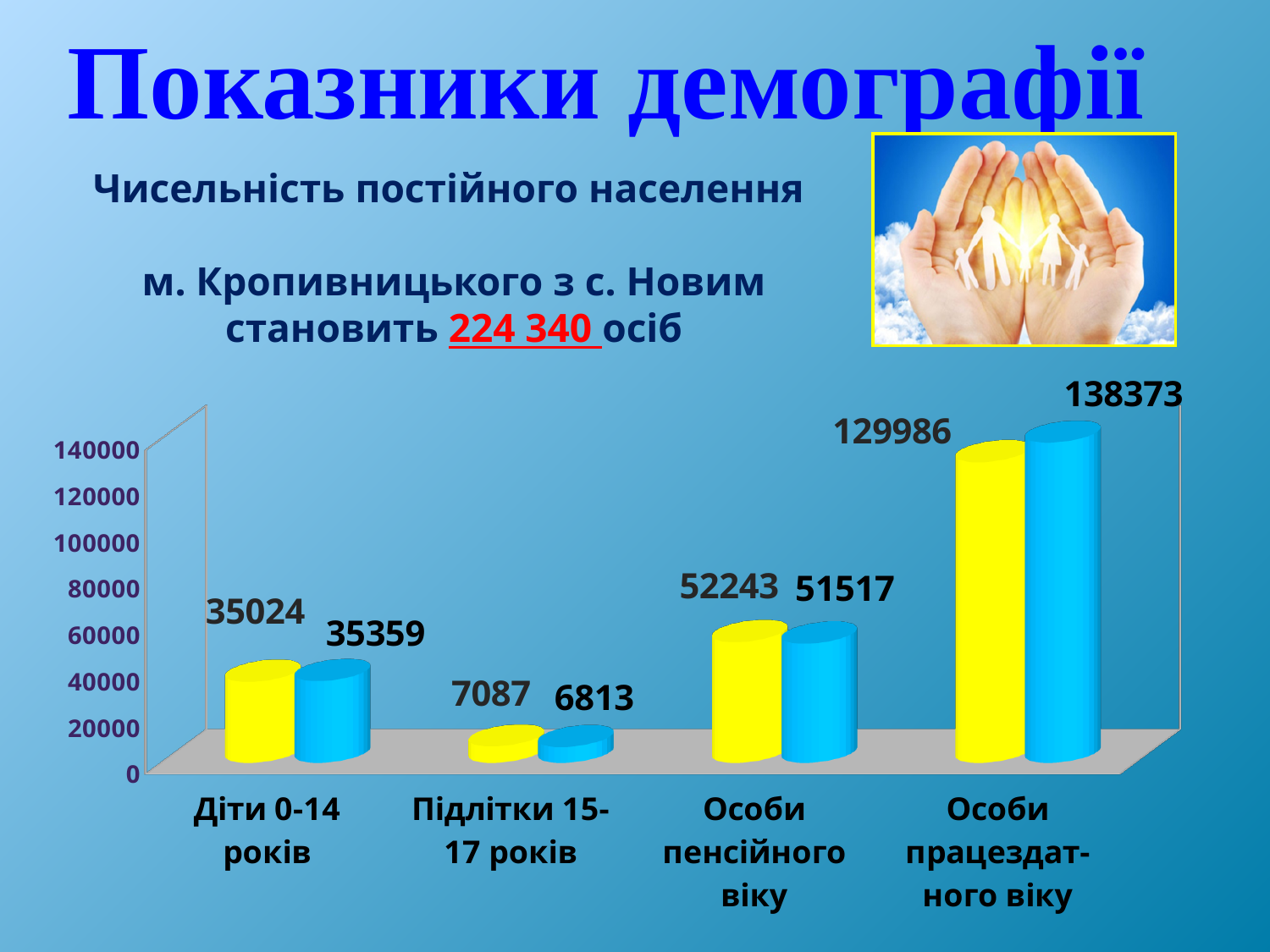
How many categories are shown on the x axis of the chart? 4 What is the value of the blue bar for Підлітки 15-17 років? 6813 What kind of chart is shown on the slide? bar chart Which is larger for Підлітки 15-17 років: the yellow bar or the blue bar? the yellow bar What total population figure is stated in the text above the chart? 224 340 What is the value of the yellow bar for Особи пенсійного віку? 52243 Which category has the lowest values in the chart? Підлітки 15-17 років Which category has the highest values in the chart? Особи працездатного віку What is the value of the yellow bar for Діти 0-14 років? 35024 What is the difference between the blue and yellow bars for Особи працездатного віку? 8387 What is the difference between the yellow and blue bars for Особи пенсійного віку? 726 What is the value of the blue bar for Особи працездатного віку? 138373